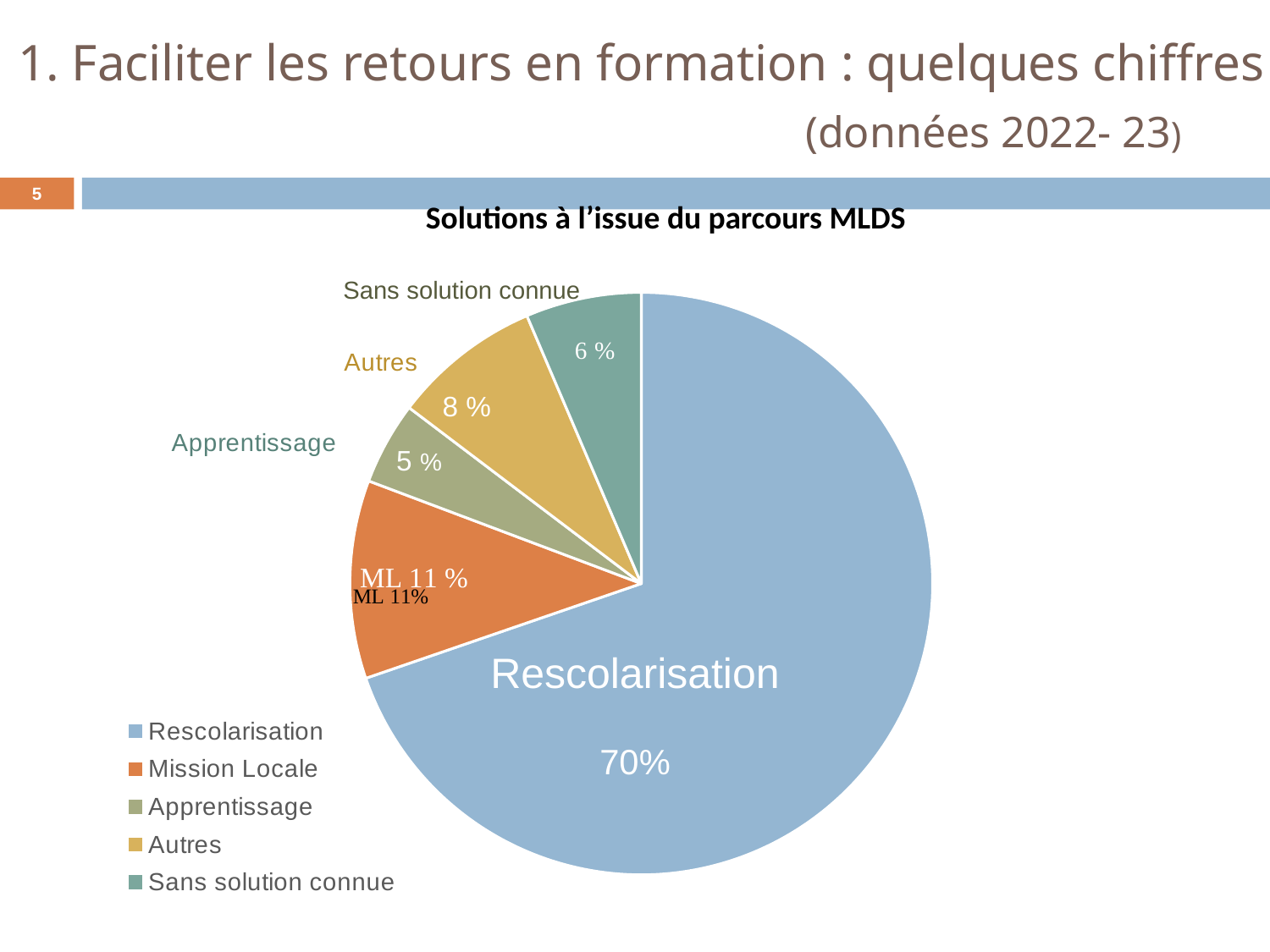
What share of the pie does Rescolarisation represent? 70% What percentage is shown for Autres? 8 % How many categories does the legend list? 5 Which is larger, the share for Autres or the share for Sans solution connue? Autres Which category has the smallest slice of the pie? Apprentissage What is the difference in percentage points between Rescolarisation and Mission Locale? 59 What percentage is shown for Mission Locale (ML)? 11 % What percentage is shown for Sans solution connue? 6 % Which category has the largest slice of the pie? Rescolarisation What is the title of the chart? Solutions à l'issue du parcours MLDS What percentage is shown for Apprentissage? 5 % What kind of chart is shown on the slide? pie chart